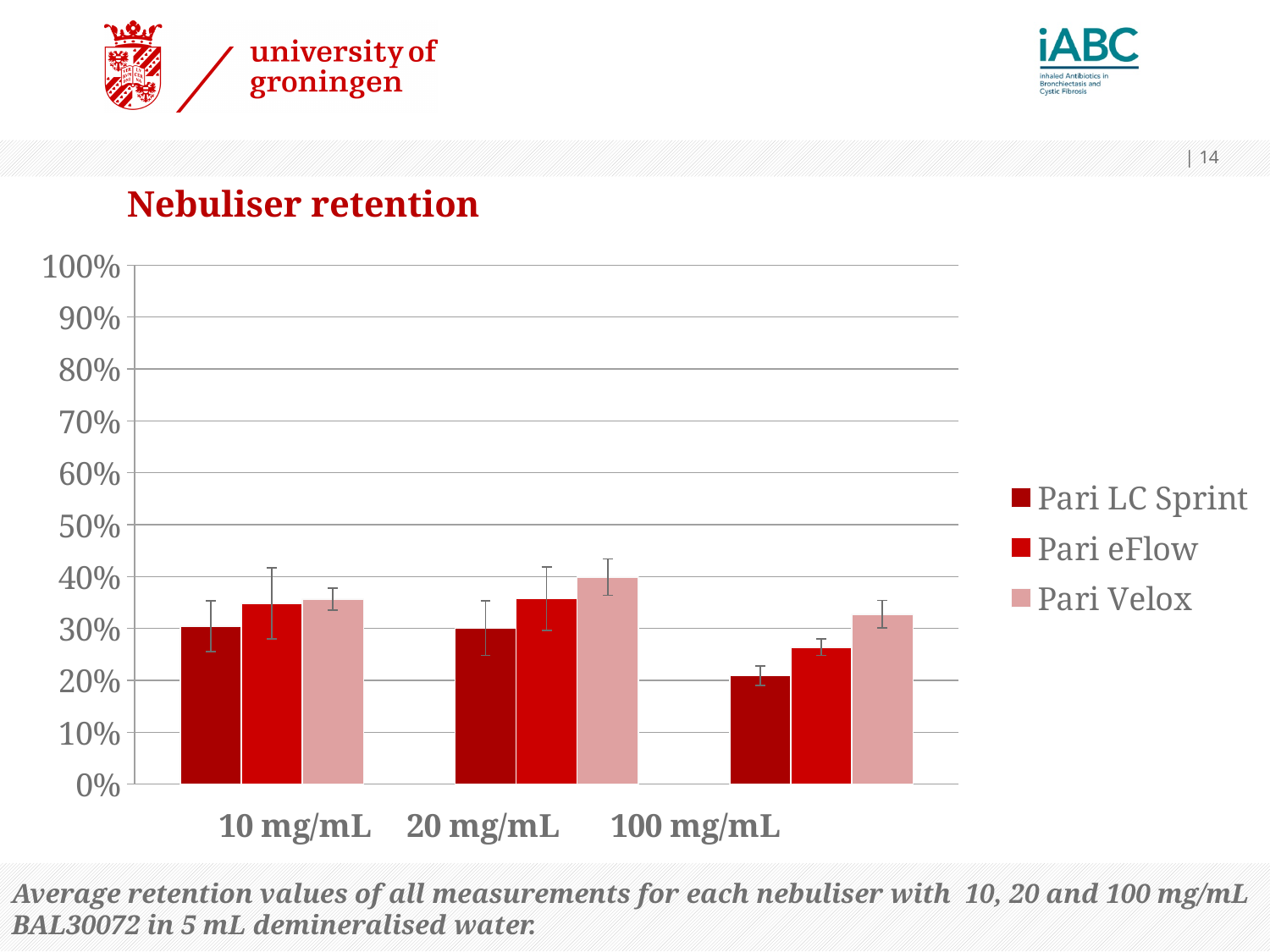
Which nebuliser has the highest retention at 100 mg/mL? Pari Velox Is the retention for Pari LC Sprint at 100 mg/mL greater or less than 30%? less What kind of chart is shown on the slide? bar chart How many concentration categories are shown on the x axis? 3 Is the retention for Pari Velox at 20 mg/mL greater or less than 30%? greater Which nebuliser has the highest retention at 20 mg/mL? Pari Velox What is the title of the chart? Nebuliser retention Does the retention for Pari Velox rise or fall from 20 mg/mL to 100 mg/mL? fall Is the retention for Pari eFlow at 100 mg/mL greater or less than 30%? less How many series does the legend list? 3 Which nebuliser has the lowest retention at 100 mg/mL? Pari LC Sprint Which is larger: Pari eFlow retention at 20 mg/mL or Pari eFlow retention at 100 mg/mL? 20 mg/mL